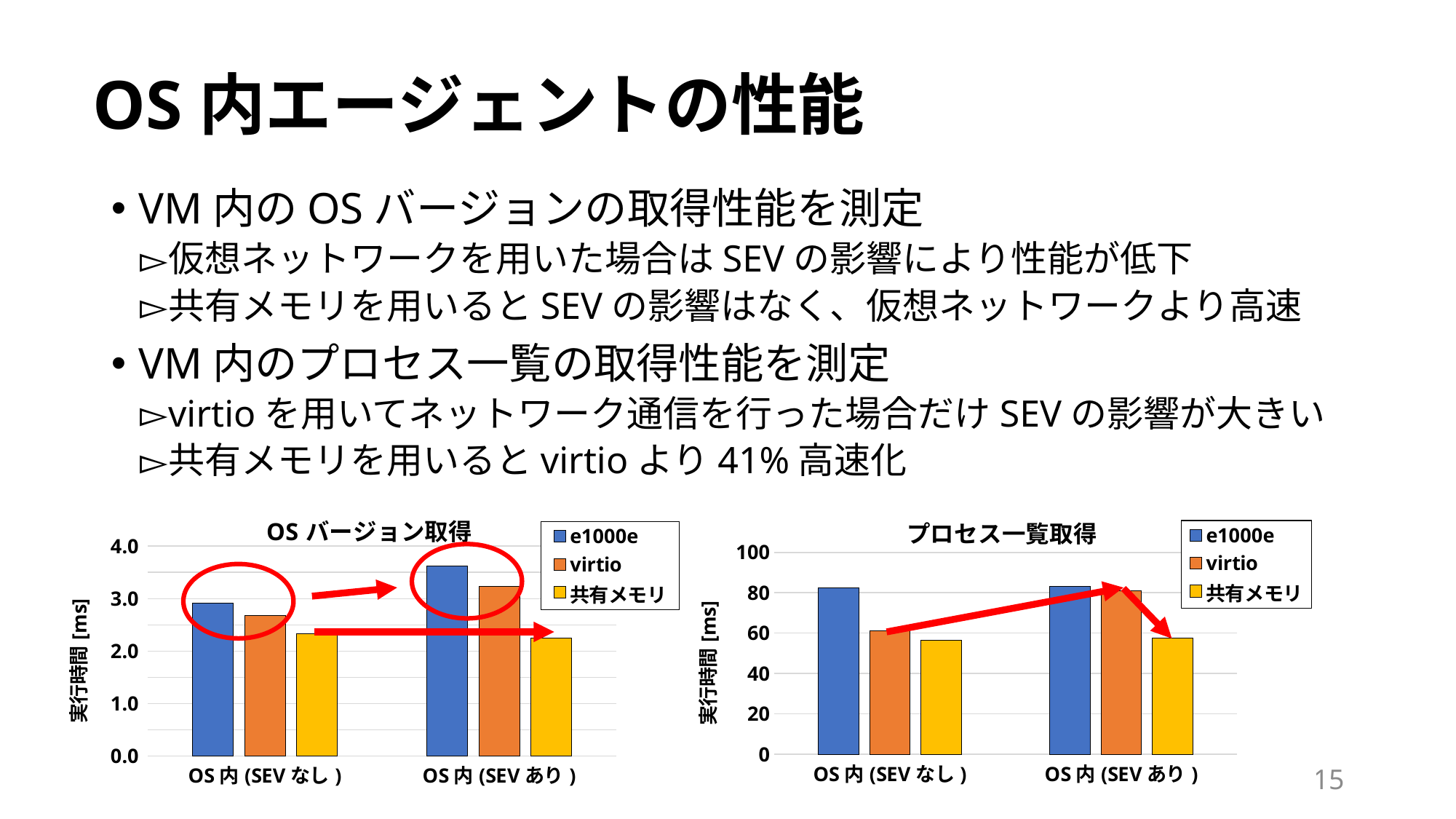
In the "OS バージョン取得" chart, does the virtio value rise or fall from OS 内 (SEV なし) to OS 内 (SEV あり)? rise In the "OS バージョン取得" chart, how many series does the legend list? 3 In the "OS バージョン取得" chart, is the value for e1000e in OS 内 (SEV あり) greater or less than 3.0? greater What is the y-axis label of the "プロセス一覧取得" chart? 実行時間 [ms] In the "プロセス一覧取得" chart, how many categories are shown on the x axis? 2 In the "プロセス一覧取得" chart, which series has the lowest value in OS 内 (SEV なし)? 共有メモリ In the "OS バージョン取得" chart, is the value for 共有メモリ in OS 内 (SEV なし) greater or less than 3.0? less In the "OS バージョン取得" chart, which series has the highest value in OS 内 (SEV あり)? e1000e In the "プロセス一覧取得" chart, is the value for 共有メモリ in OS 内 (SEV あり) greater or less than 60? less What kind of chart is the "OS バージョン取得" chart? bar chart In the "プロセス一覧取得" chart, which is larger for OS 内 (SEV なし): e1000e or virtio? e1000e